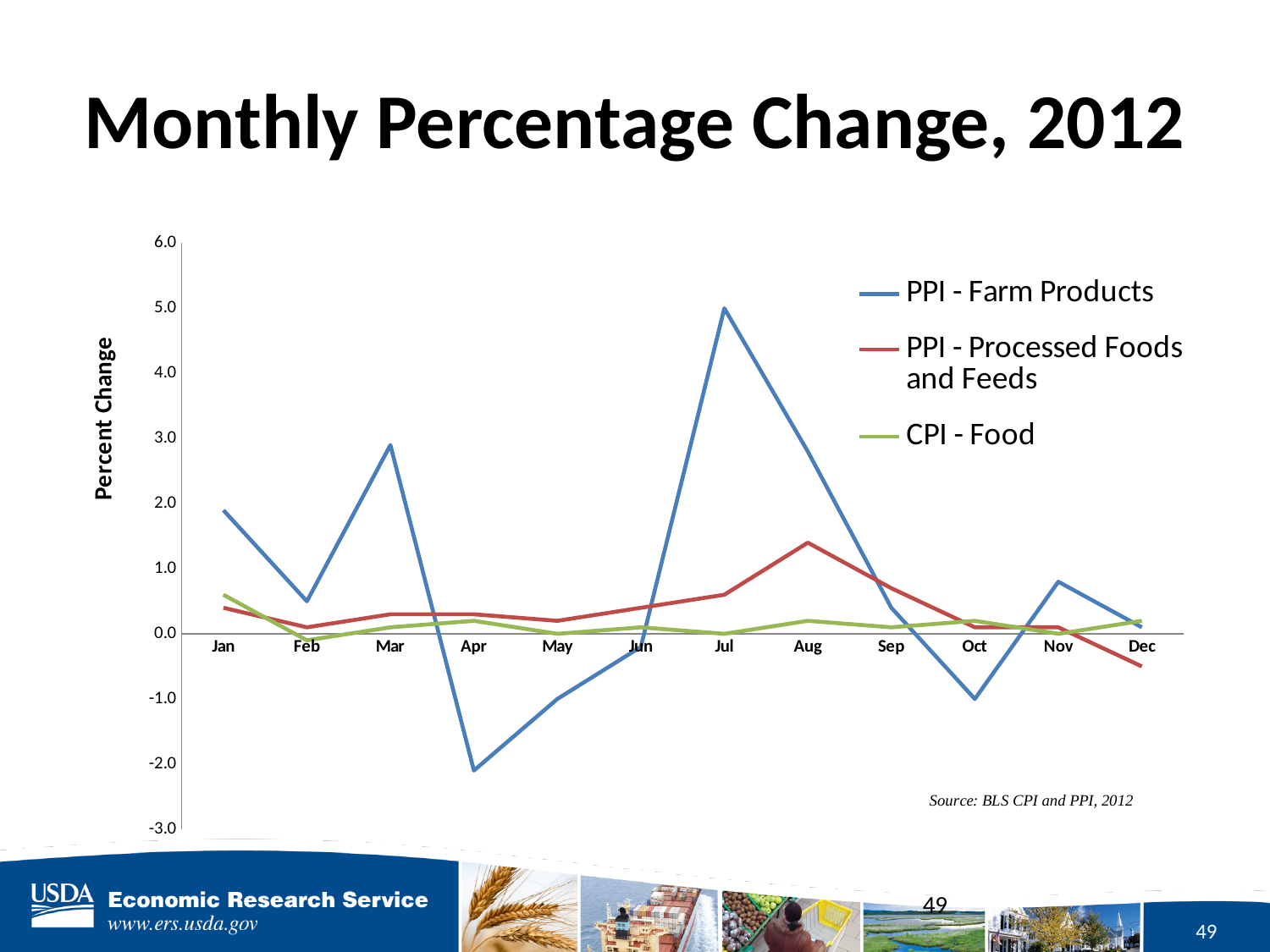
What kind of chart is shown on the slide? Line chart Is the value for PPI - Farm Products in Jul greater or less than 4.0? greater Is the value for PPI - Farm Products in Apr greater or less than -1.0? less Does PPI - Farm Products rise or fall from Jul to Oct? Fall In which month does PPI - Farm Products reach its highest value? Jul What is the label on the y axis? Percent Change How many months are plotted along the x axis? 12 In which month does PPI - Processed Foods and Feeds reach its highest value? Aug In which month does PPI - Farm Products reach its lowest value? Apr How many series does the legend list? 3 Is the value for PPI - Processed Foods and Feeds in Aug greater or less than 1.0? greater In Jul, which series has the larger value: PPI - Farm Products or CPI - Food? PPI - Farm Products